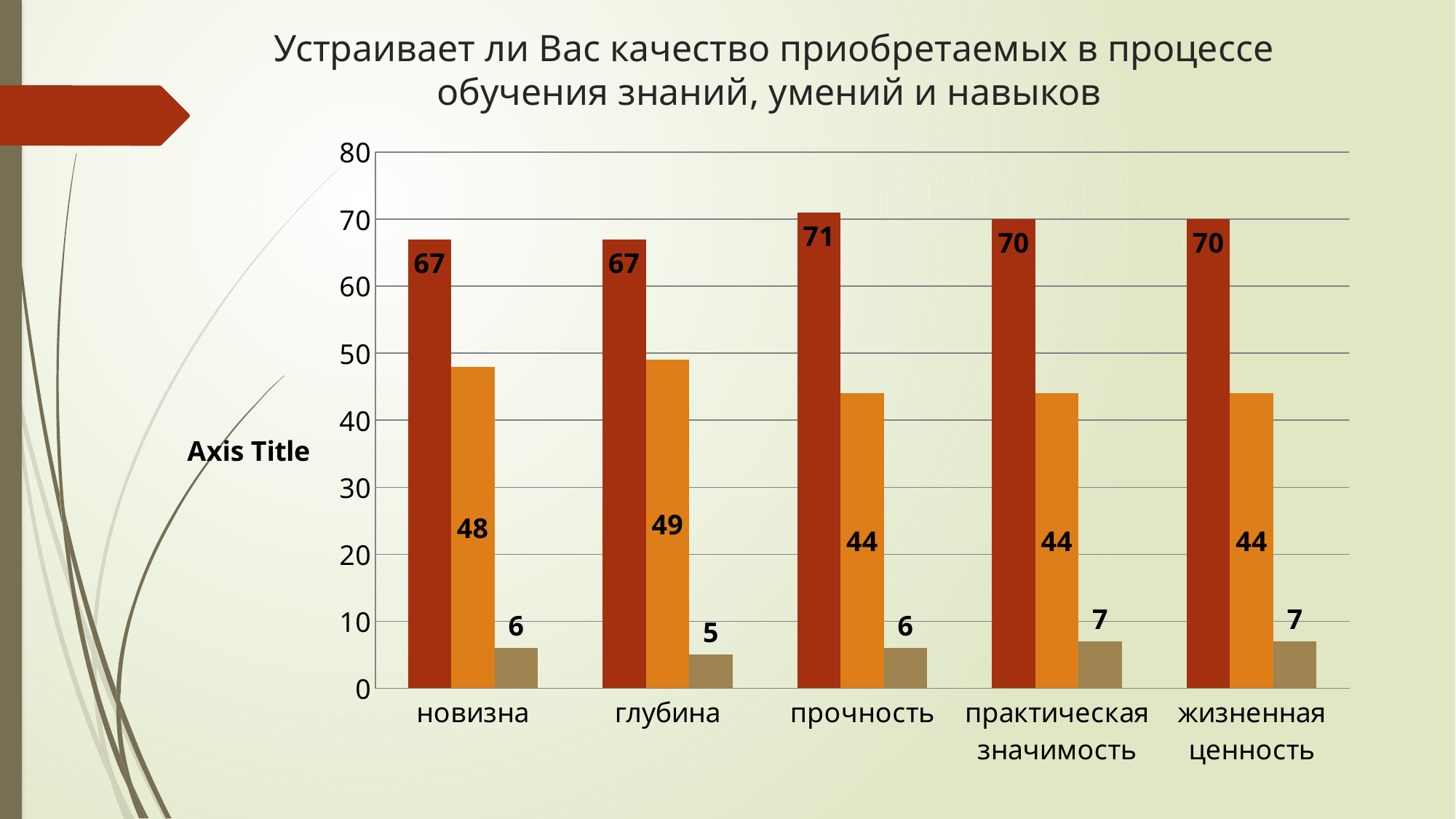
What is the value of the dark red bar for прочность? 71 What is the title of the chart? Устраивает ли Вас качество приобретаемых в процессе обучения знаний, умений и навыков Which is larger: the orange bar for глубина or the orange bar for прочность? глубина How many categories are shown on the x axis? 5 Is the value of the dark red bar for новизна greater or less than 60? greater What is the label shown on the vertical axis? Axis Title What is the value of the orange bar for глубина? 49 Which category has the highest dark red bar? прочность What is the value of the brown bar for практическая значимость? 7 What is the difference between the dark red bar and the orange bar for новизна? 19 What kind of chart is shown on the slide? bar chart Which category has the lowest brown bar? глубина